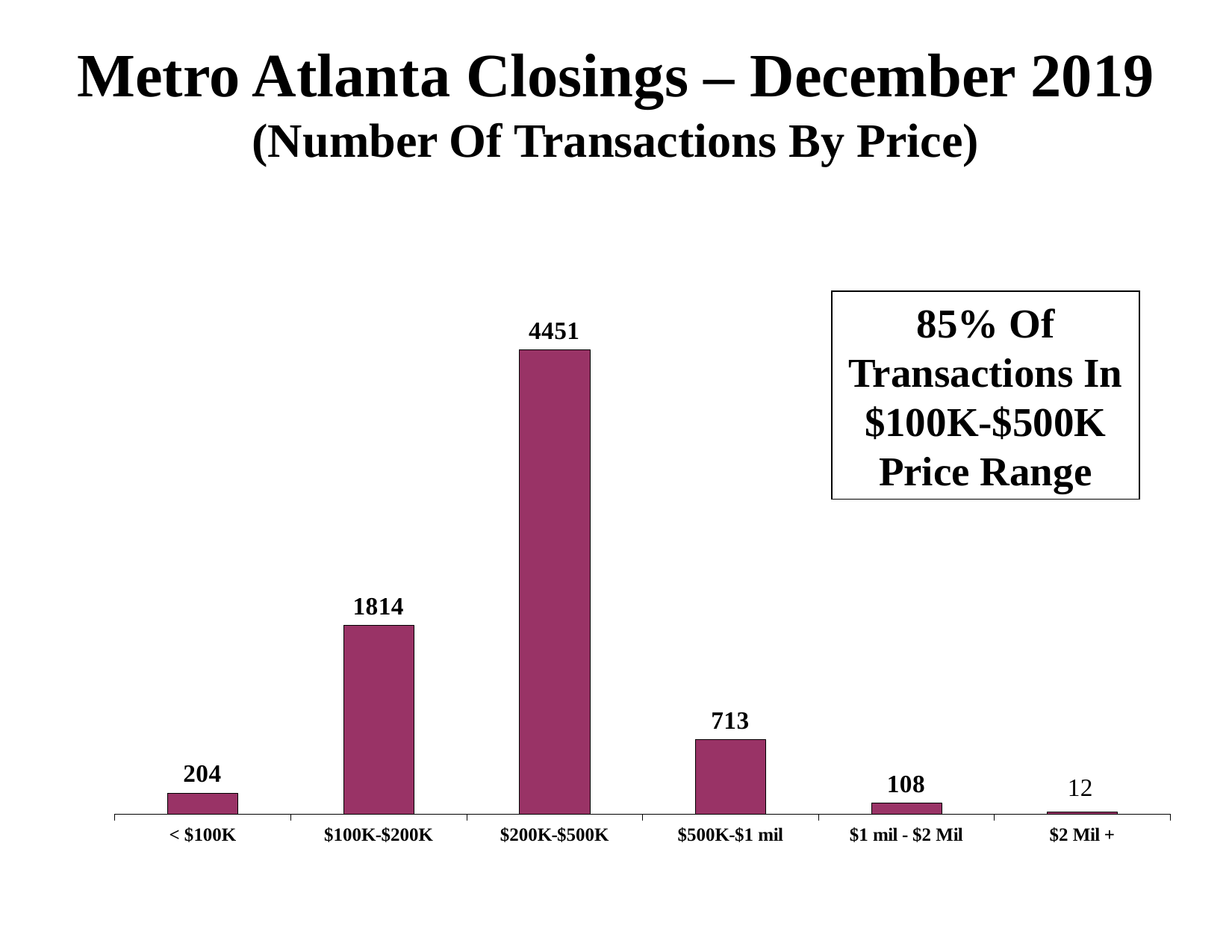
How many price range categories are shown on the chart? 6 What is the total of the $100K-$200K and $200K-$500K values? 6265 According to the text box on the slide, what percentage of transactions were in the $100K-$500K price range? 85% What is the value for the $2 Mil + category? 12 Which price range has the lowest number of transactions? $2 Mil + How many transactions were in the $200K-$500K price range? 4451 What kind of chart is shown on the slide? Bar chart What is the value for the < $100K category? 204 How many transactions were in the $1 mil - $2 Mil range? 108 What is the difference between the $100K-$200K and $500K-$1 mil values? 1101 Which is larger, the value for $500K-$1 mil or the value for < $100K? $500K-$1 mil Which price range has the highest number of transactions? $200K-$500K